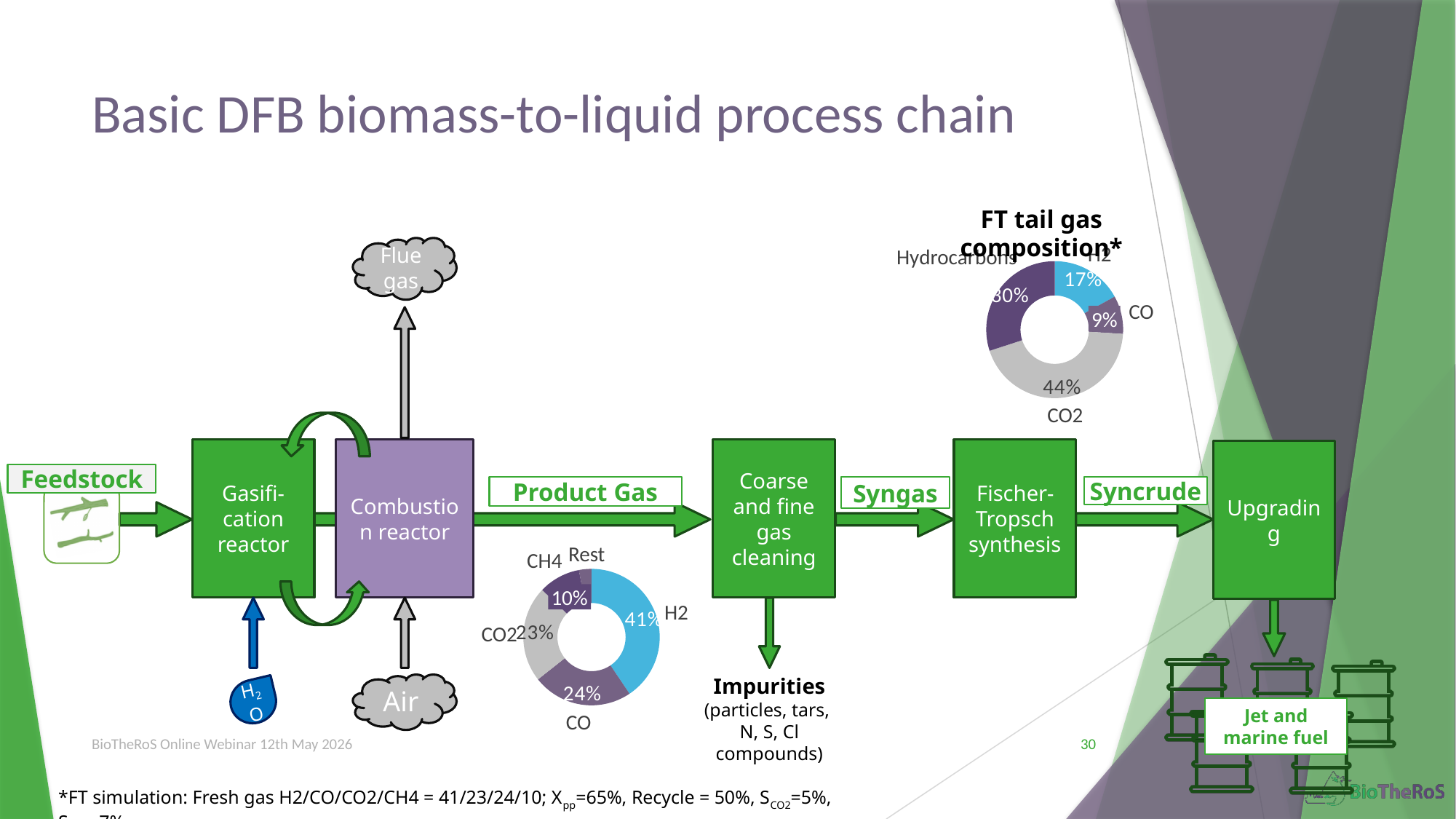
In the FT tail gas composition chart, what share is H2? 17% In the donut chart below the Product Gas arrow, what share is CH4? 10% What is the title of the donut chart in the upper right of the slide? FT tail gas composition* In the donut chart below the Product Gas arrow, which is larger, CO or CO2? CO In the FT tail gas composition chart, which component has the smallest share? CO In the donut chart below the Product Gas arrow, what share is H2? 41% In the FT tail gas composition chart, what is the difference between the Hydrocarbons share and the CO share? 21% What type of chart is the FT tail gas composition chart? Donut (pie) chart In the donut chart below the Product Gas arrow, what is the difference between the H2 share and the CO share? 17% How many slices are labelled in the donut chart below the Product Gas arrow? 5 In the FT tail gas composition chart, what share is CO2? 44% In the FT tail gas composition chart, which component has the largest share? CO2